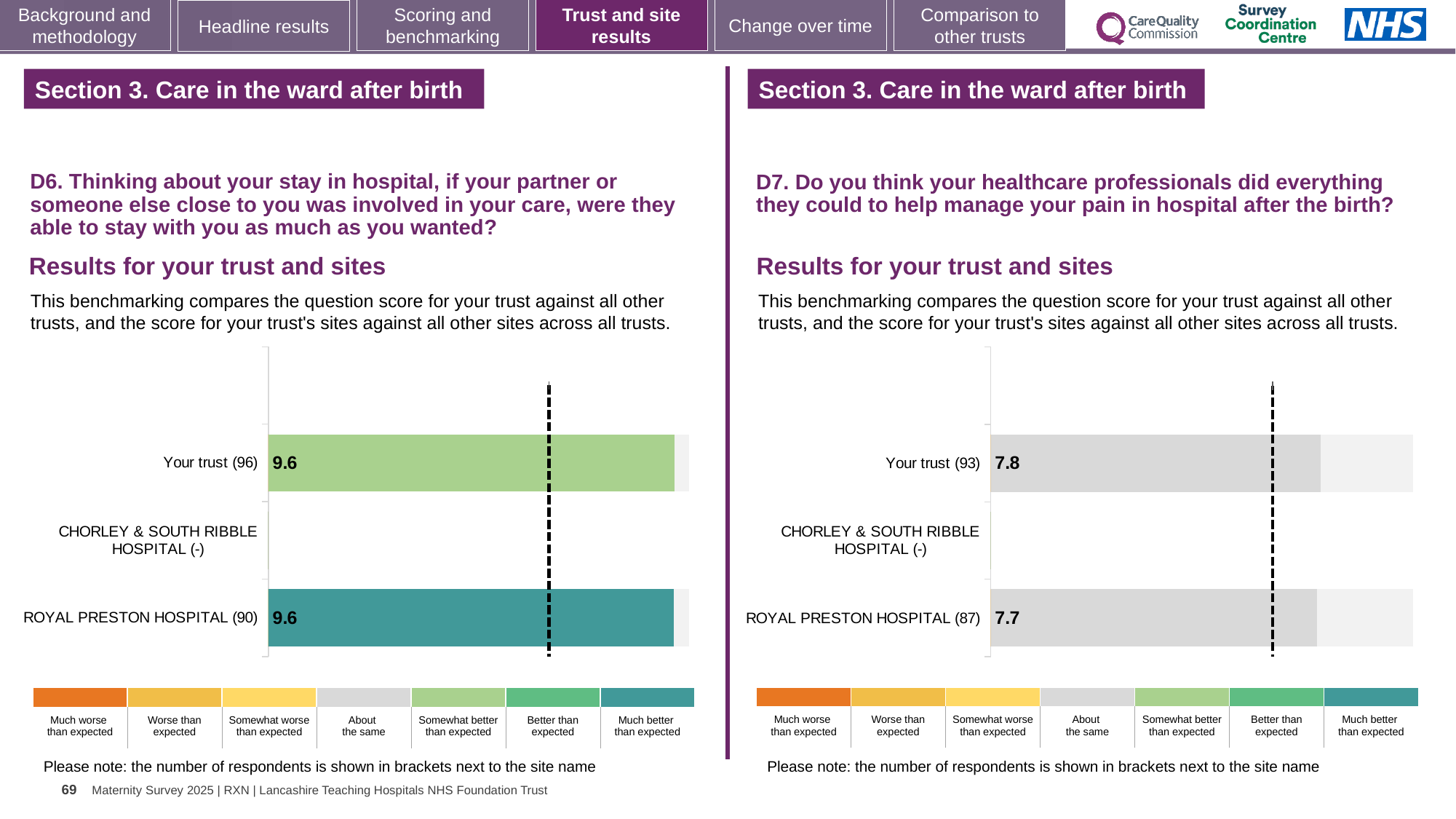
In the D6 chart on the left, what is the difference between the score for Your trust and the score for ROYAL PRESTON HOSPITAL? 0 In the D7 chart on the right, which has the higher score: Your trust or ROYAL PRESTON HOSPITAL? Your trust In the D6 chart on the left, which benchmarking category does the colour of the ROYAL PRESTON HOSPITAL bar correspond to in the legend? Much better than expected In the D6 chart on the left, what is the score for ROYAL PRESTON HOSPITAL? 9.6 In the D7 chart on the right, how many respondents are shown in brackets for Your trust? 93 In the D6 chart on the left, what is the score for Your trust? 9.6 How many categories are listed on the y axis of the D6 chart on the left? 3 In the D6 chart on the left, how many respondents are shown in brackets for ROYAL PRESTON HOSPITAL? 90 In the D7 chart on the right, what is the score for Your trust? 7.8 What kind of chart is the D7 chart on the right? Bar chart In the D7 chart on the right, what is the score for ROYAL PRESTON HOSPITAL? 7.7 In the D7 chart on the right, what is the difference between the score for Your trust and the score for ROYAL PRESTON HOSPITAL? 0.1